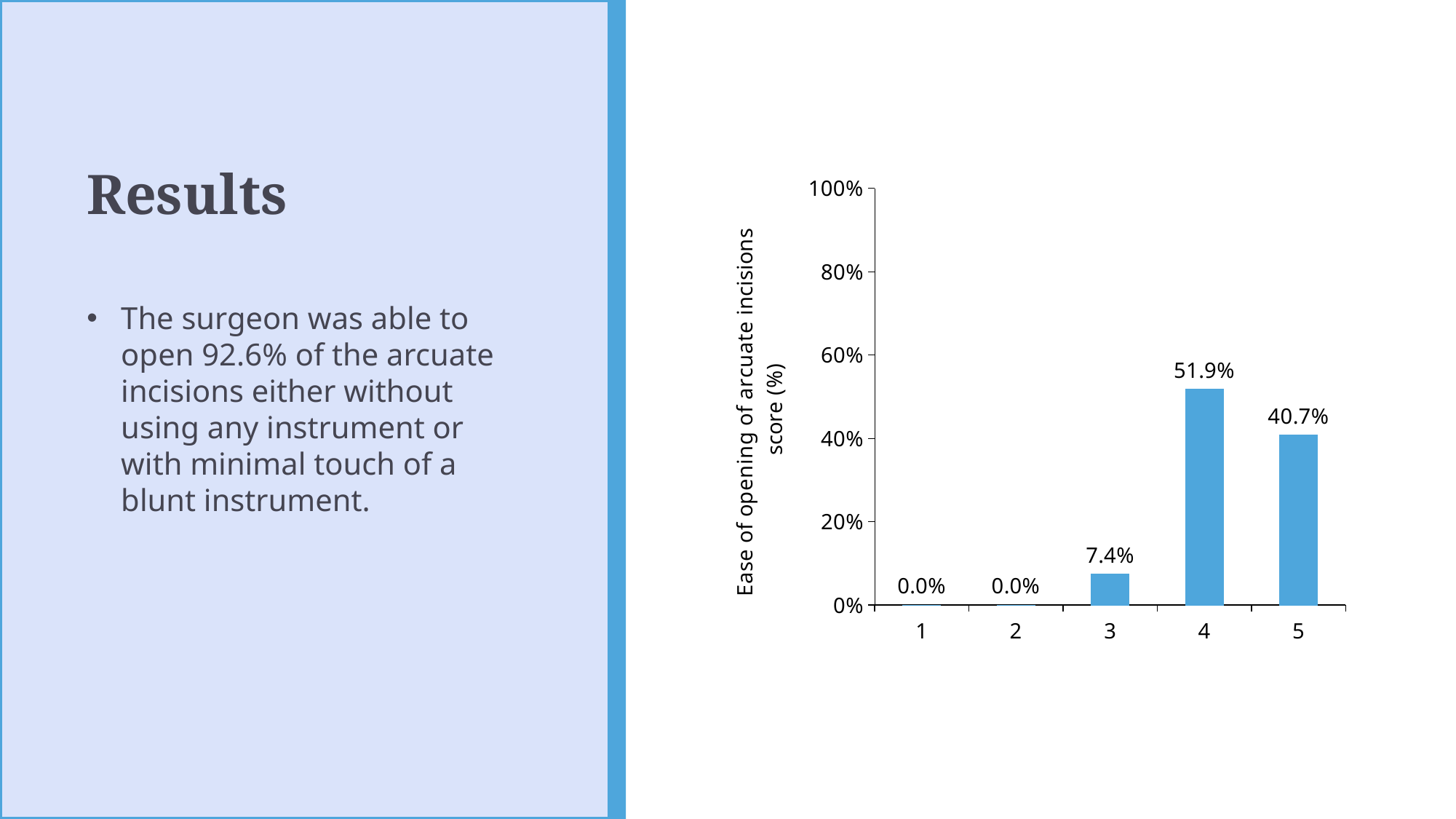
What is the label of the y axis? Ease of opening of arcuate incisions score (%) What is the value for score 5? 40.7% What is the value for score 1? 0.0% Which score has the highest value? 4 What kind of chart is shown on the slide? bar chart Which is larger, the value for score 3 or the value for score 5? 5 What is the value for score 3? 7.4% What is the total of the values for scores 4 and 5 combined? 92.6% What is the difference between the values for score 4 and score 5? 11.2% Is the value for score 4 greater or less than 40%? greater What is the value for score 4? 51.9% How many score categories are shown on the x axis? 5